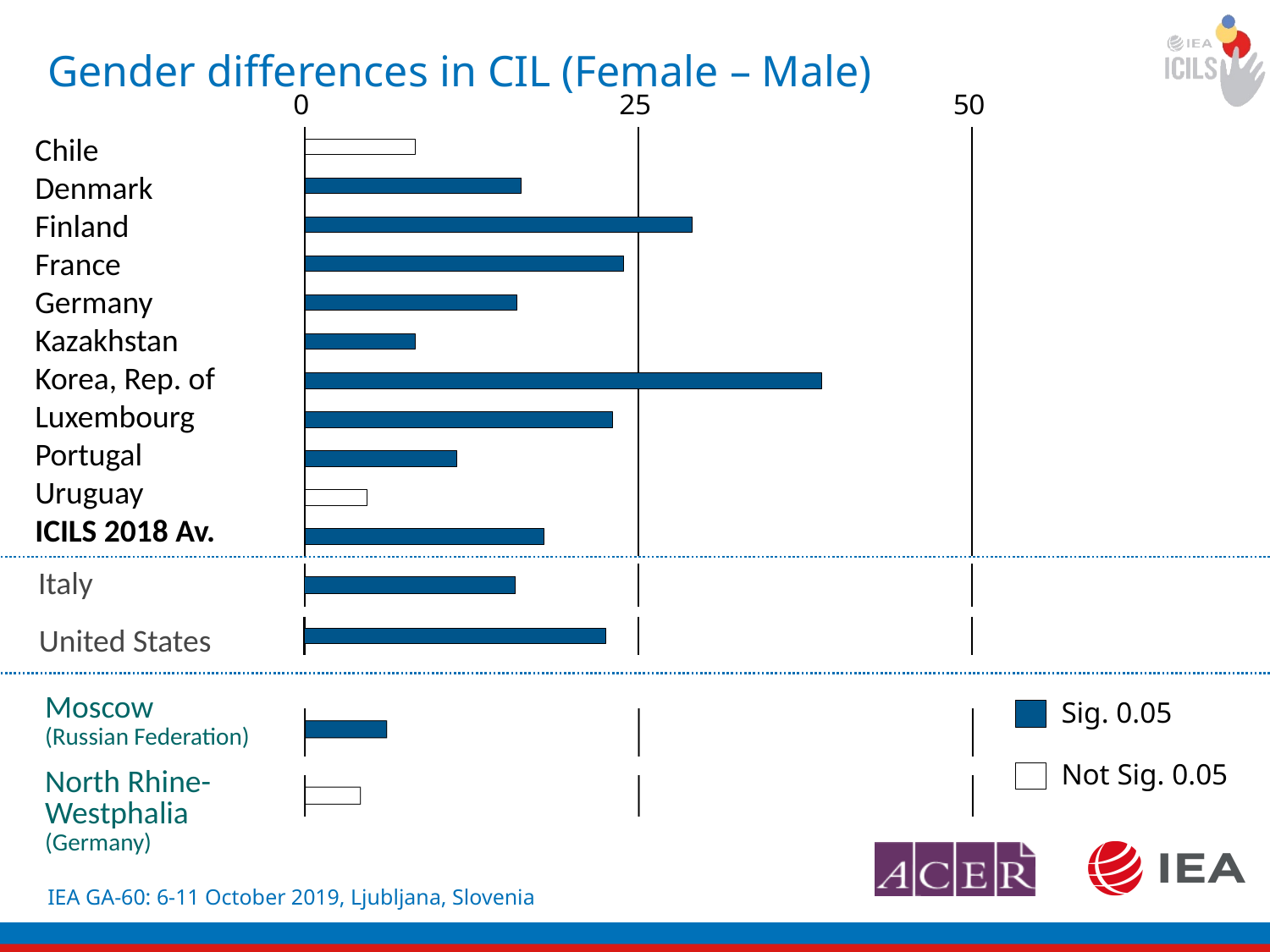
Which has the larger value, Korea, Rep. of or Luxembourg? Korea, Rep. of Which bars are shown as 'Not Sig. 0.05' (white)? Chile, Uruguay, North Rhine-Westphalia Is the value for Kazakhstan greater or less than 25? less Is the value for Finland greater or less than 25? greater What kind of chart is shown on the slide? Bar chart How many entries does the legend list? 2 Which country has the largest gender difference in CIL (Female – Male)? Korea, Rep. of How many bars are plotted on the chart? 15 Which has the larger value, Germany or Portugal? Germany Is the value for Chile greater or less than 25? less Which has the larger value, Finland or Denmark? Finland